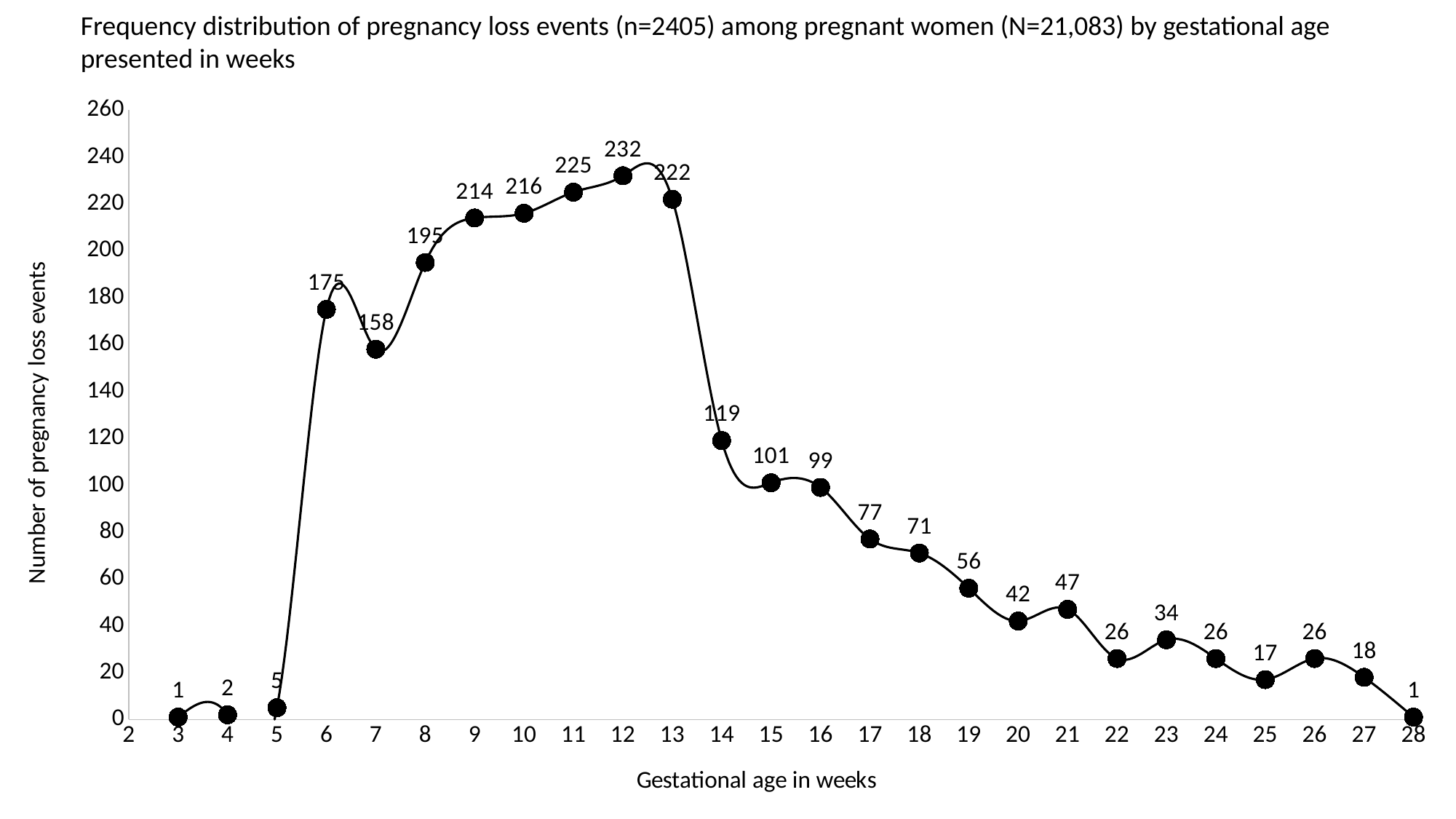
How many data points are plotted on the chart? 26 Which gestational week has more pregnancy loss events, week 21 or week 23? week 21 How many pregnancy loss events occurred at gestational week 20? 42 What is the difference in pregnancy loss events between week 12 and week 13? 10 What is the label of the y axis? Number of pregnancy loss events Which gestational week has more pregnancy loss events, week 6 or week 8? week 8 How many pregnancy loss events occurred at gestational week 12? 232 How many pregnancy loss events occurred at gestational week 7? 158 What is the difference in pregnancy loss events between week 14 and week 15? 18 What type of chart is shown on the slide? line chart At which gestational week is the number of pregnancy loss events highest? 12 Do the number of pregnancy loss events rise or fall from week 13 to week 28? fall